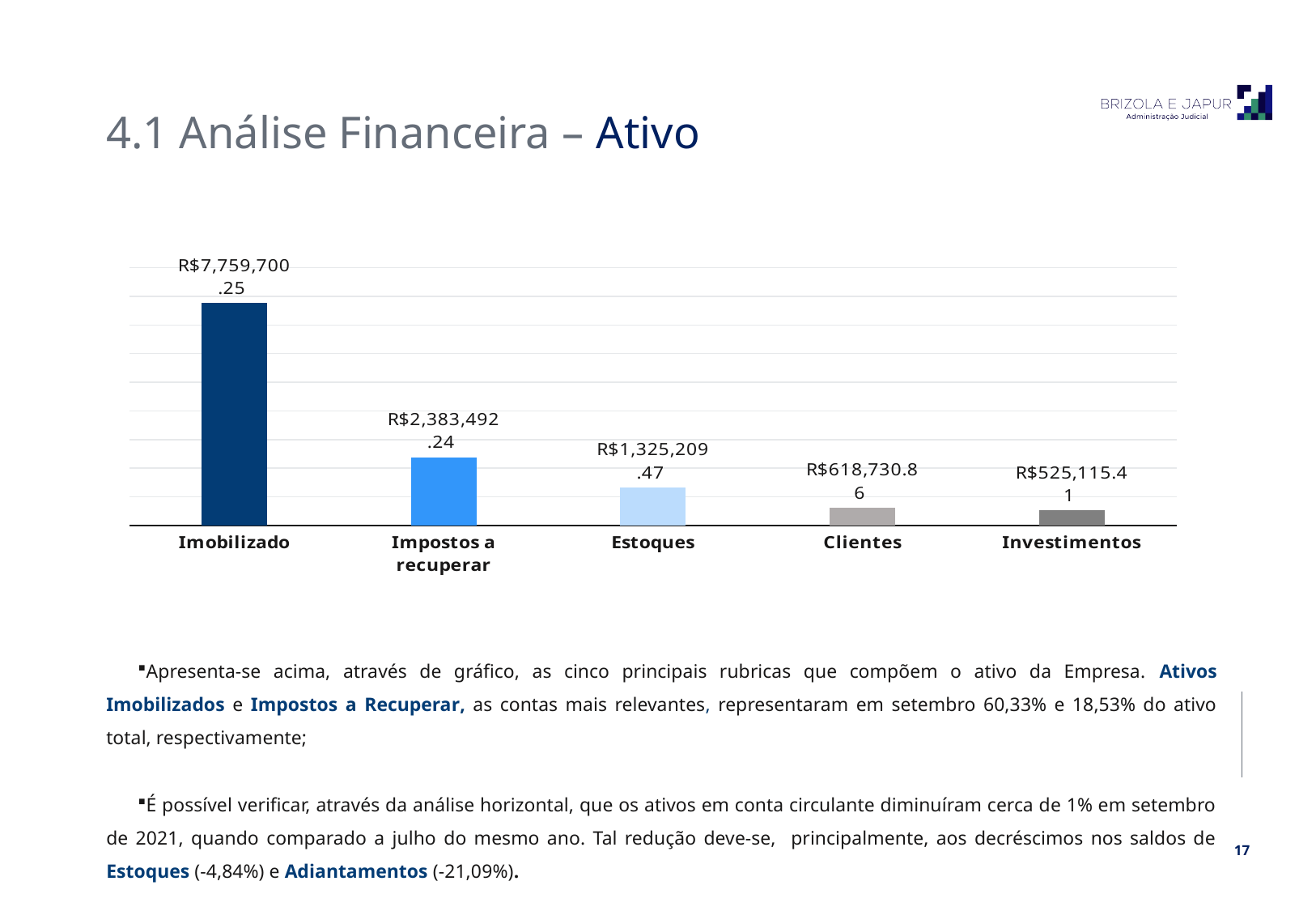
What is the value shown for Estoques? R$1,325,209.47 What is the value shown for Impostos a recuperar? R$2,383,492.24 What is the value shown for Investimentos? R$525,115.41 What is the difference between the values for Imobilizado and Impostos a recuperar? R$5,376,208.01 Which category has the lowest value? Investimentos Which is larger, the value for Estoques or the value for Clientes? Estoques What kind of chart is shown on the slide? Bar chart What is the value shown for Clientes? R$618,730.86 What is the value shown for Imobilizado? R$7,759,700.25 What is the difference between the values for Clientes and Investimentos? R$93,615.45 Which category has the highest value? Imobilizado How many categories are shown in the chart? 5